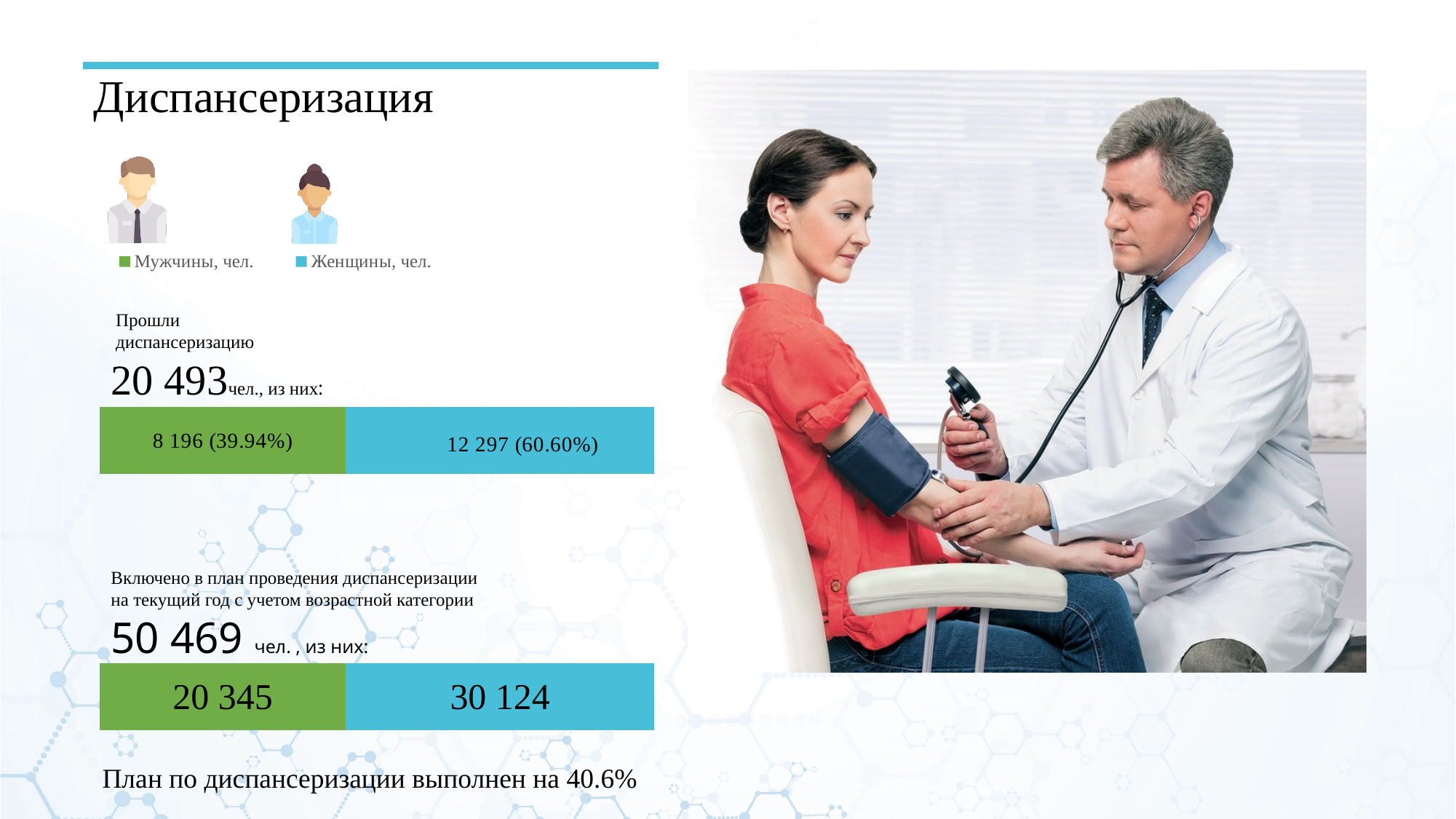
In the upper bar (Прошли диспансеризацию), what is the value for Мужчины, чел.? 8 196 (39.94%) In the lower bar (Включено в план проведения диспансеризации), what is the value for Женщины, чел.? 30 124 In the lower bar (Включено в план проведения диспансеризации), which series has the smaller value? Мужчины, чел. In the lower bar (Включено в план проведения диспансеризации), what is the difference between the Женщины and Мужчины values? 9 779 In the lower bar (Включено в план проведения диспансеризации), what is the value for Мужчины, чел.? 20 345 In the upper bar (Прошли диспансеризацию), what is the difference between the Женщины and Мужчины values? 4 101 In the upper bar (Прошли диспансеризацию), which series has the larger value, Мужчины or Женщины? Женщины What is the total of the lower stacked bar (Включено в план проведения диспансеризации)? 50 469 How many series does the legend list? 2 What colour represents Женщины, чел. in the legend? Blue In the upper bar (Прошли диспансеризацию), what is the value for Женщины, чел.? 12 297 (60.60%) What is the total of the upper stacked bar (Прошли диспансеризацию)? 20 493